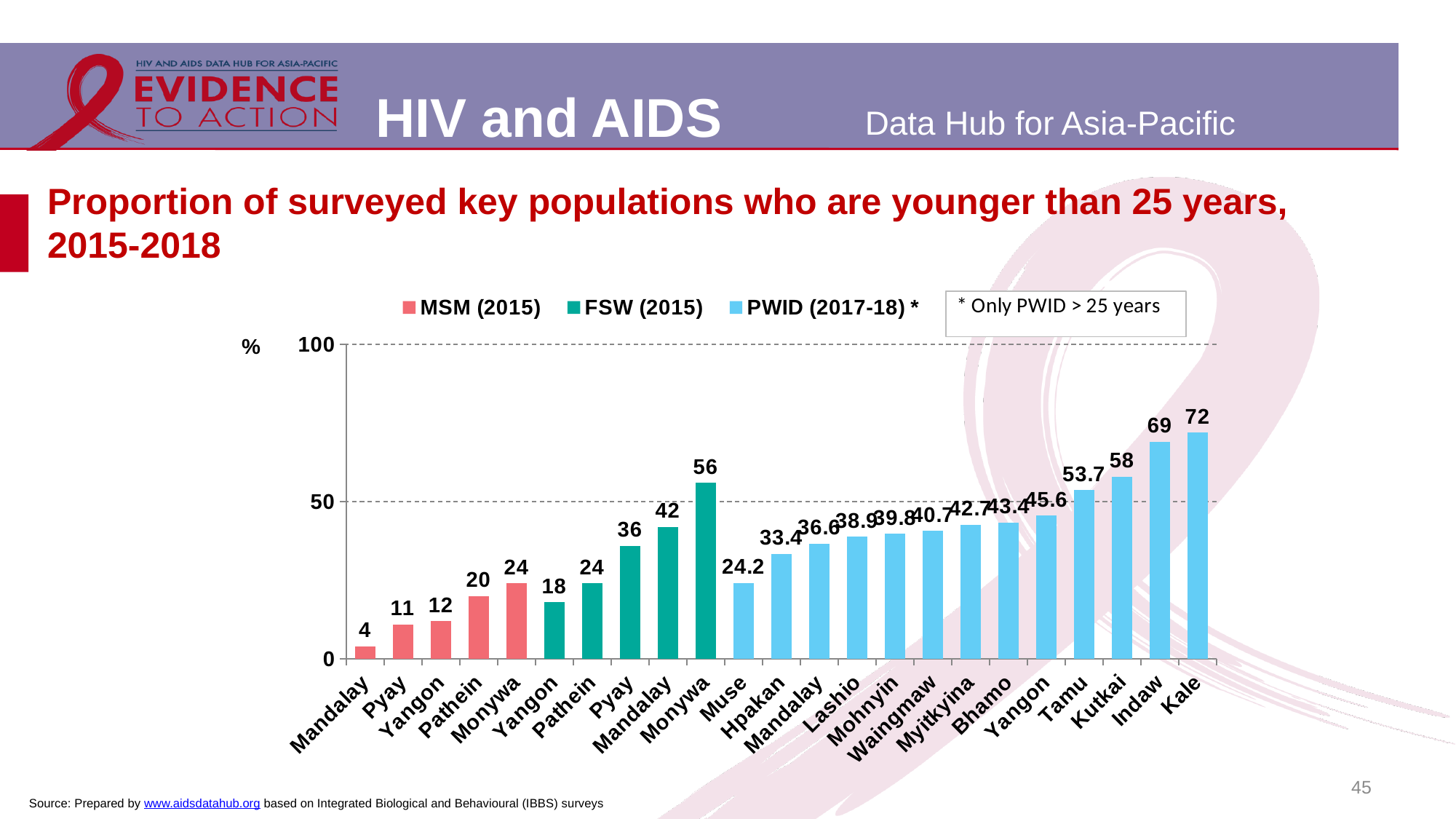
What is the value for Kale in the PWID (2017-18) series? 72 What is the value for Monywa in the FSW (2015) series? 56 How many series does the legend list? 3 Which location has the lowest value in the PWID (2017-18) series? Muse How many bars are plotted in the chart in total? 23 What is the value for Muse in the PWID (2017-18) series? 24.2 What is the difference between the FSW (2015) value for Monywa and the FSW (2015) value for Yangon? 38 What type of chart is shown on the slide? bar chart Which location has the highest value in the MSM (2015) series? Monywa What is the value for Mandalay in the MSM (2015) series? 4 Which is larger: the MSM (2015) value for Pathein or the FSW (2015) value for Pathein? FSW (2015) value for Pathein What does the note in the box next to the legend say? * Only PWID > 25 years